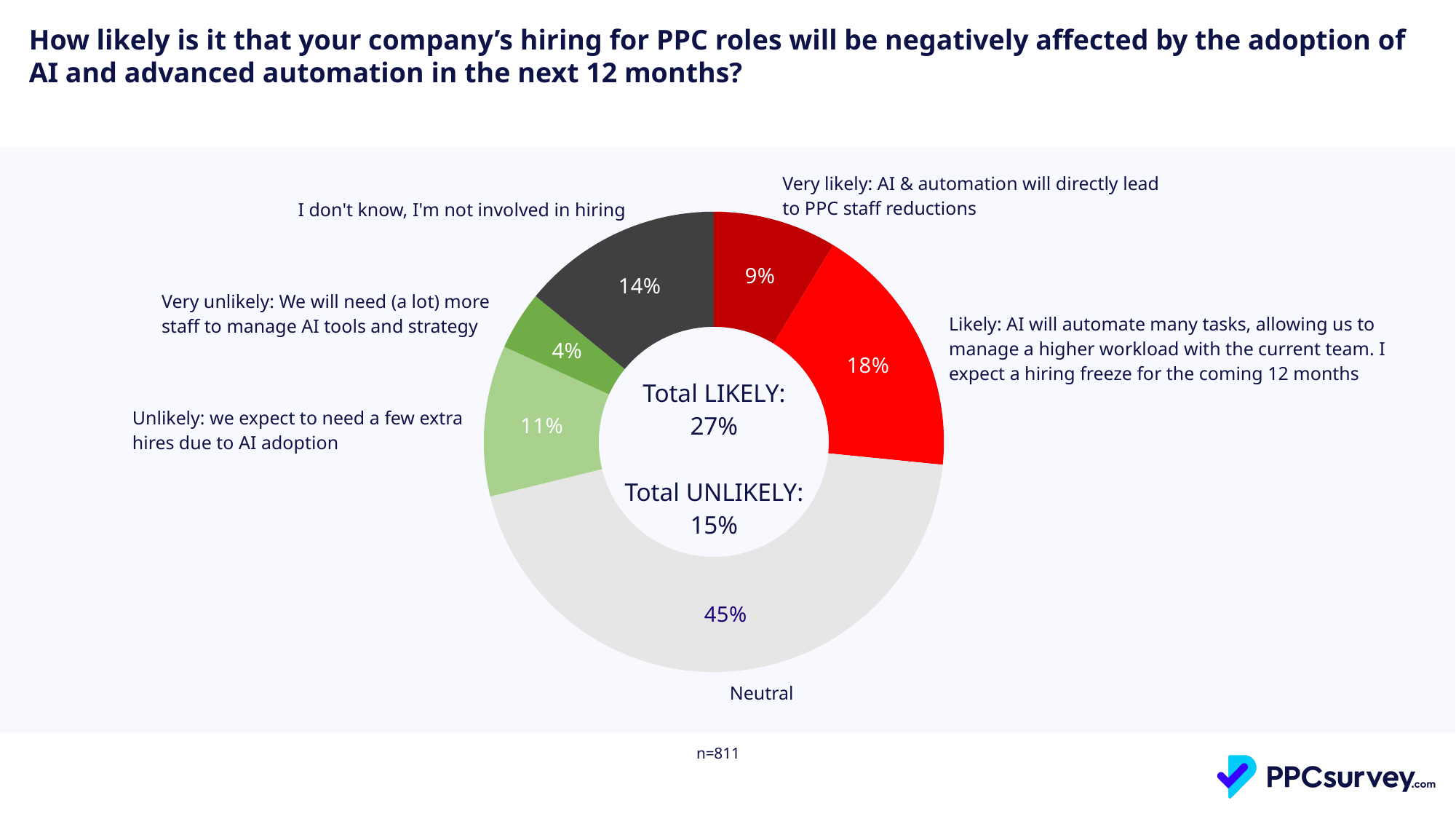
What kind of chart is shown on the slide? Pie chart (donut) What percentage of respondents answered Neutral? 45% What percentage of respondents said it is Very likely that AI & automation will directly lead to PPC staff reductions? 9% What is the difference in percentage points between the Likely (18%) and Very likely (9%) responses? 9 percentage points What percentage of respondents chose 'I don't know, I'm not involved in hiring'? 14% Which is larger: the share for Unlikely or the share for 'I don't know, I'm not involved in hiring'? I don't know, I'm not involved in hiring Which response category has the smallest share of the pie? Very unlikely: We will need (a lot) more staff to manage AI tools and strategy What percentage of respondents said it is Very unlikely, expecting to need (a lot) more staff to manage AI tools and strategy? 4% How many response categories are shown in the chart? 6 What is the Total LIKELY percentage shown in the centre of the chart? 27% Which response category has the largest share of the pie? Neutral What is the sample size (n) shown on the slide? n=811